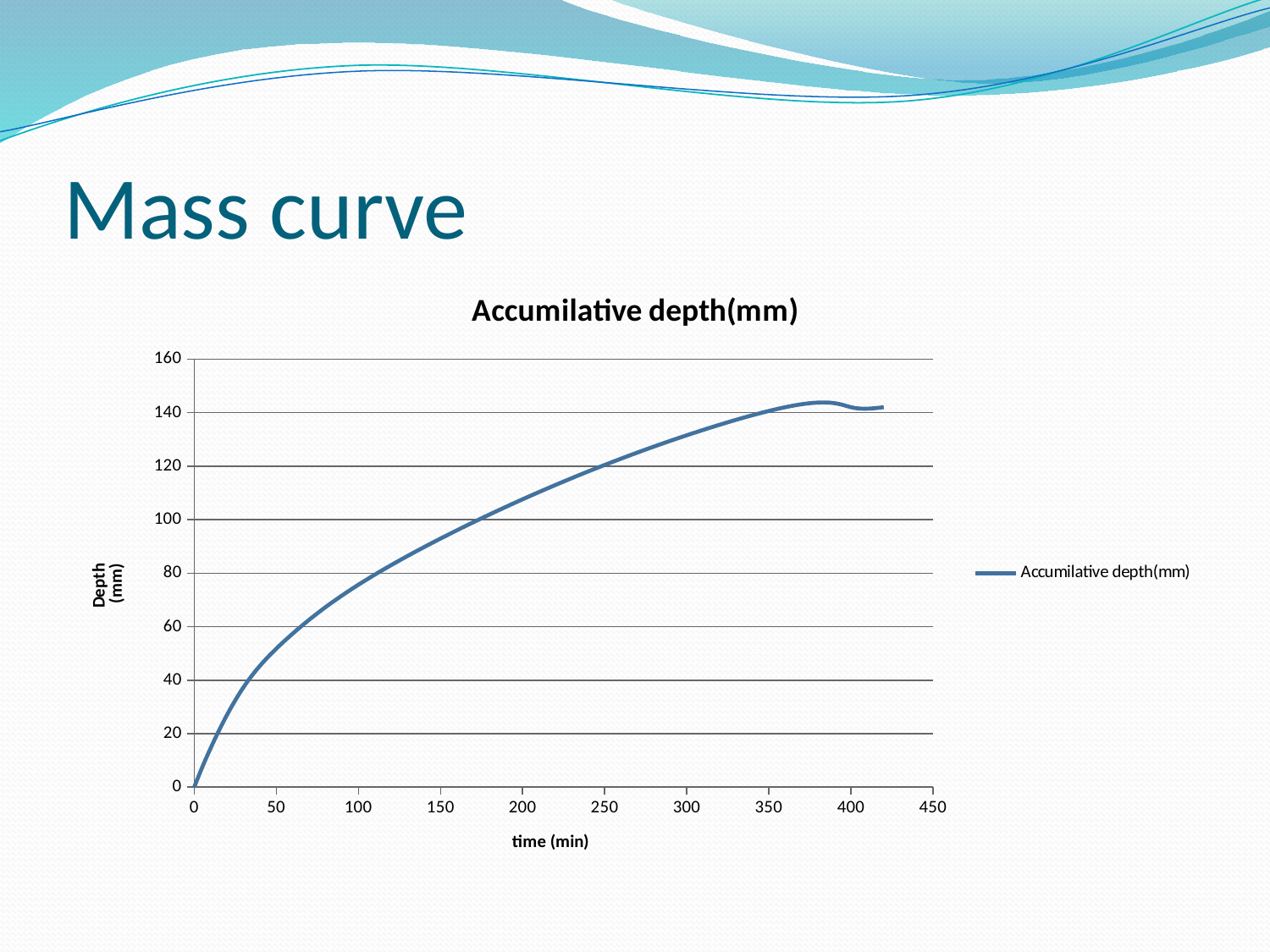
What is the title of the chart? Accumilative depth(mm) Is the accumulative depth at 150 min greater or less than 100? less What is the accumulative depth at time 0 min? 0 Is the accumulative depth at 300 min greater or less than 120? greater Is the highest accumulative depth on the curve greater or less than 160? less What kind of chart is shown on the slide? line chart How many series does the legend list? 1 Does the accumulative depth rise or fall as time increases from 0 to 350 min? rise What is the label of the x axis? time (min)